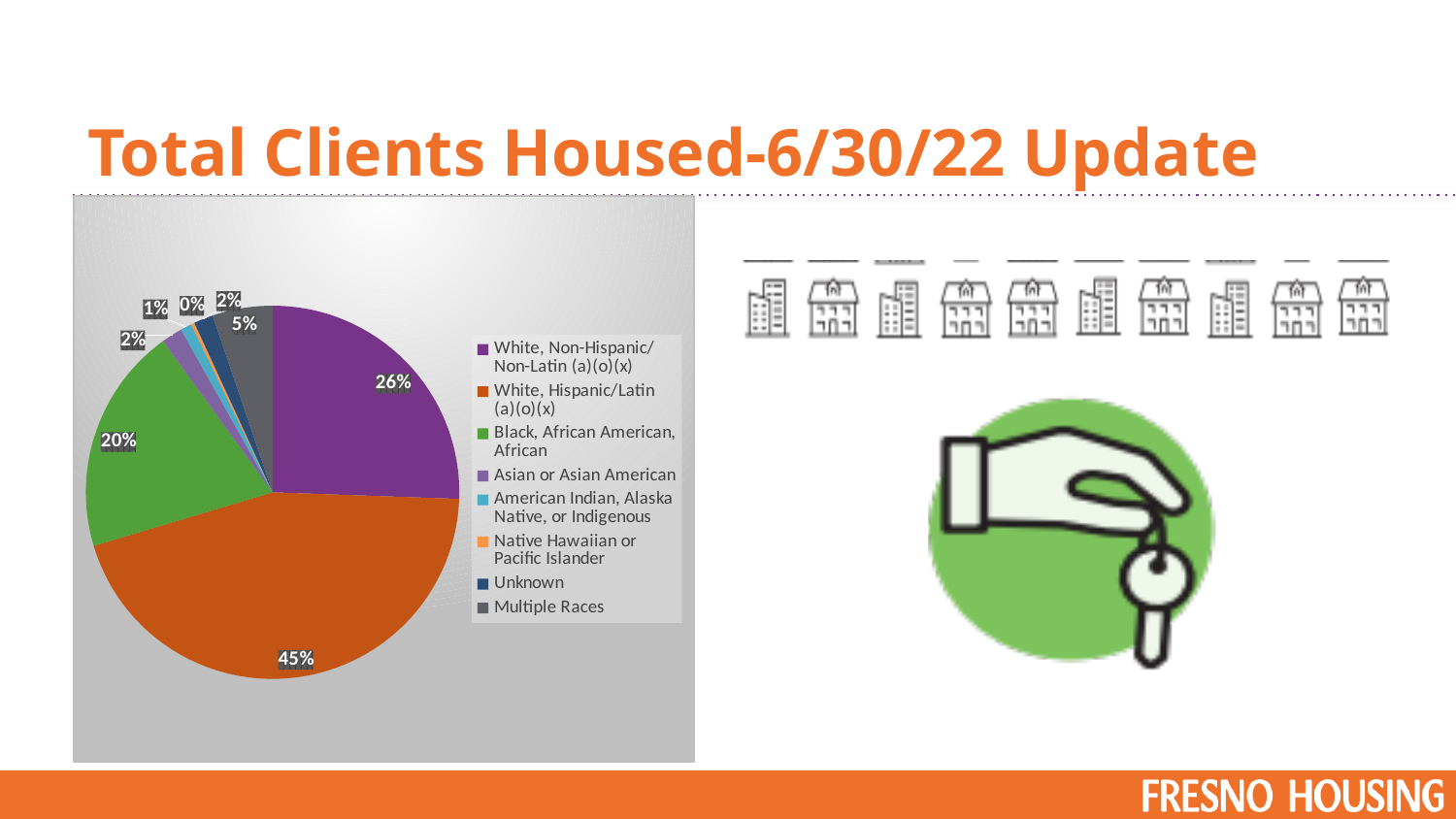
What is the title of the slide containing the chart? Total Clients Housed-6/30/22 Update Which category has the largest share of the pie? White, Hispanic/Latin (a)(o)(x) How many categories does the legend list? 8 Which is larger: the share for Black, African American, African or the share for Multiple Races? Black, African American, African What kind of chart is shown on the slide? pie chart What share of clients housed is White, Non-Hispanic/Non-Latin (a)(o)(x)? 26% What share of clients housed is White, Hispanic/Latin (a)(o)(x)? 45% Which category has the smallest share of the pie? Native Hawaiian or Pacific Islander What share of clients housed is Multiple Races? 5% What share of clients housed is Native Hawaiian or Pacific Islander? 0% What share of clients housed is Black, African American, African? 20% What is the difference in percentage points between the White, Hispanic/Latin (a)(o)(x) share and the White, Non-Hispanic/Non-Latin (a)(o)(x) share? 19